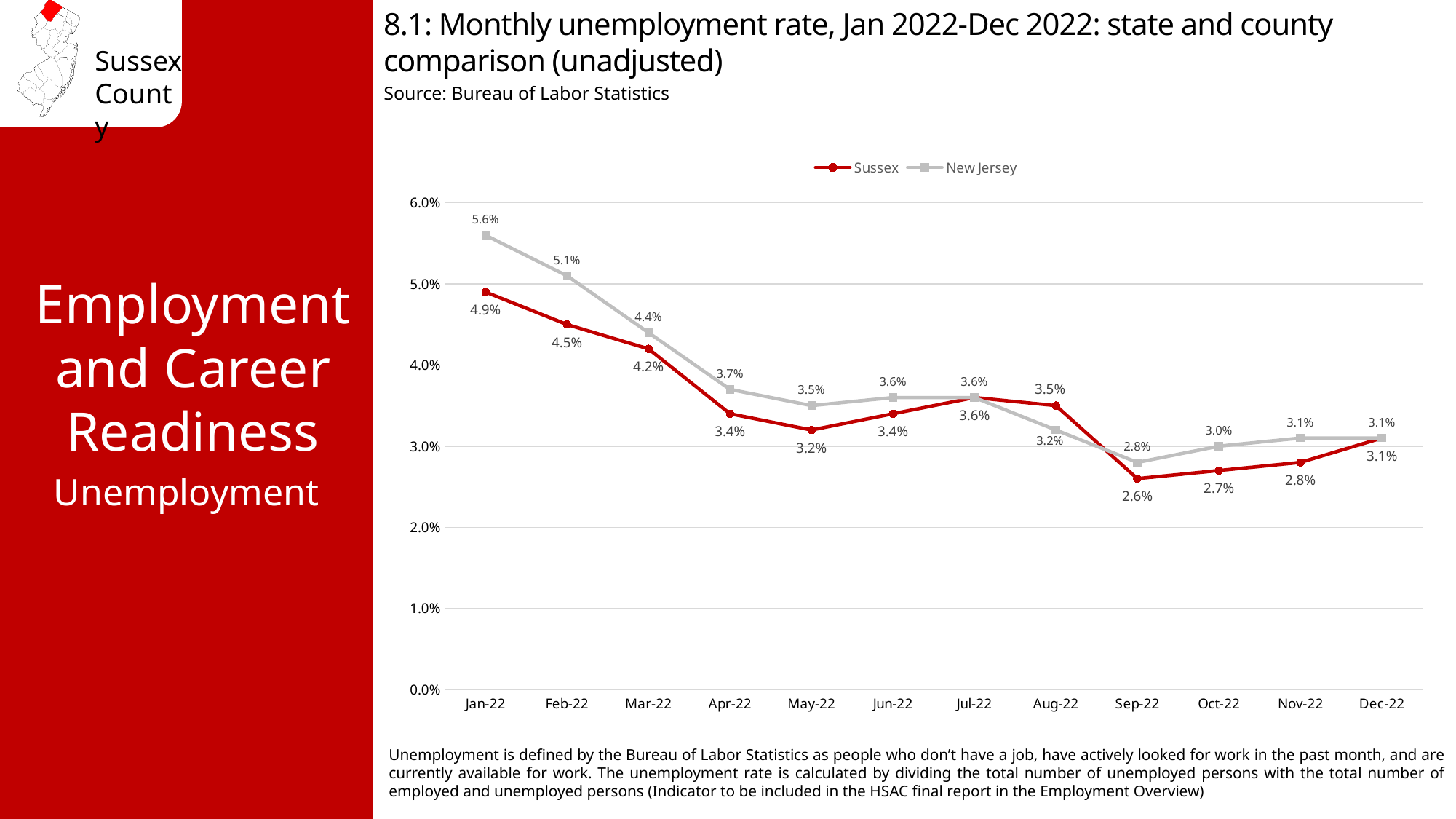
In which month was the Sussex unemployment rate lowest? Sep-22 What was the New Jersey unemployment rate in Mar-22? 4.4% What kind of chart is shown on the slide? Line chart What was the Sussex unemployment rate in Jan-22? 4.9% Is the Sussex unemployment rate in Feb-22 greater or less than 4.0%? greater In Aug-22, which had the higher unemployment rate, Sussex or New Jersey? Sussex What is the difference between the New Jersey and Sussex unemployment rates in Jan-22? 0.7% How many months are plotted on the x axis? 12 In which month was the New Jersey unemployment rate highest? Jan-22 Does the New Jersey unemployment rate rise or fall from Jan-22 to Apr-22? Fall What was the Sussex unemployment rate in Sep-22? 2.6% How many series does the legend list? 2